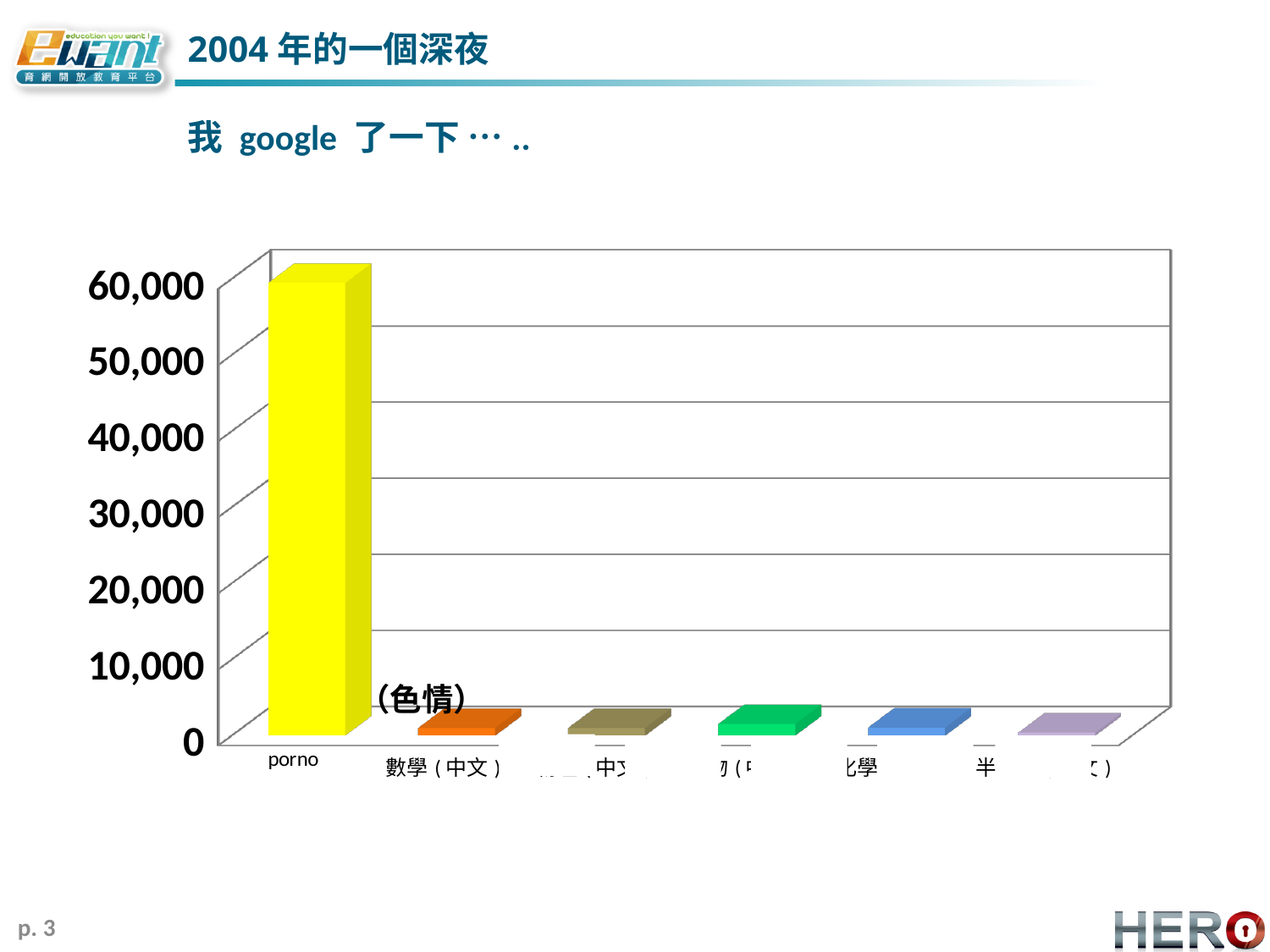
How many bars are plotted in the chart? 6 What kind of chart is shown on the slide? bar chart Which is larger, the value for porno or the value for 數學(中文)? porno Is the value for porno greater or less than 50,000? greater Is the value for 數學(中文) greater or less than 10,000? less What is the highest value labelled on the vertical axis? 60,000 What colour is the bar for porno? yellow Which category has the highest bar? porno